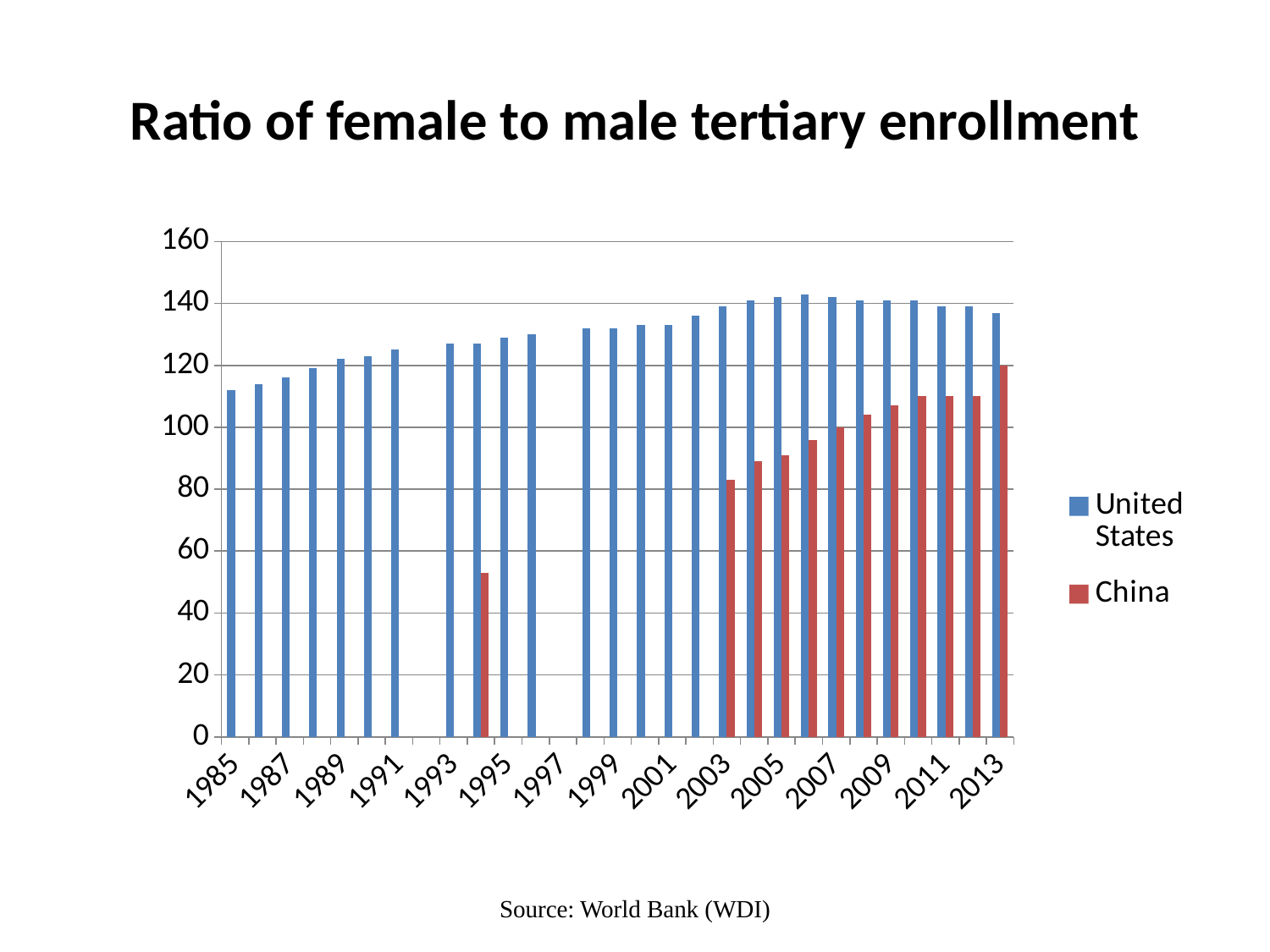
Is the value for the United States in 1985 greater or less than 100? greater How many series does the legend list? 2 What kind of chart is shown on the slide? bar chart Which colour represents China in the chart? red In 2013, which series has the larger value, United States or China? United States Is the value for the United States in 2013 greater or less than 140? less Do the China values rise or fall from 2003 to 2013? rise Is the value for China in 2003 greater or less than 100? less For China, which year has the lowest value? 1994 What is the title of the chart? Ratio of female to male tertiary enrollment For China, which year has the highest value? 2013